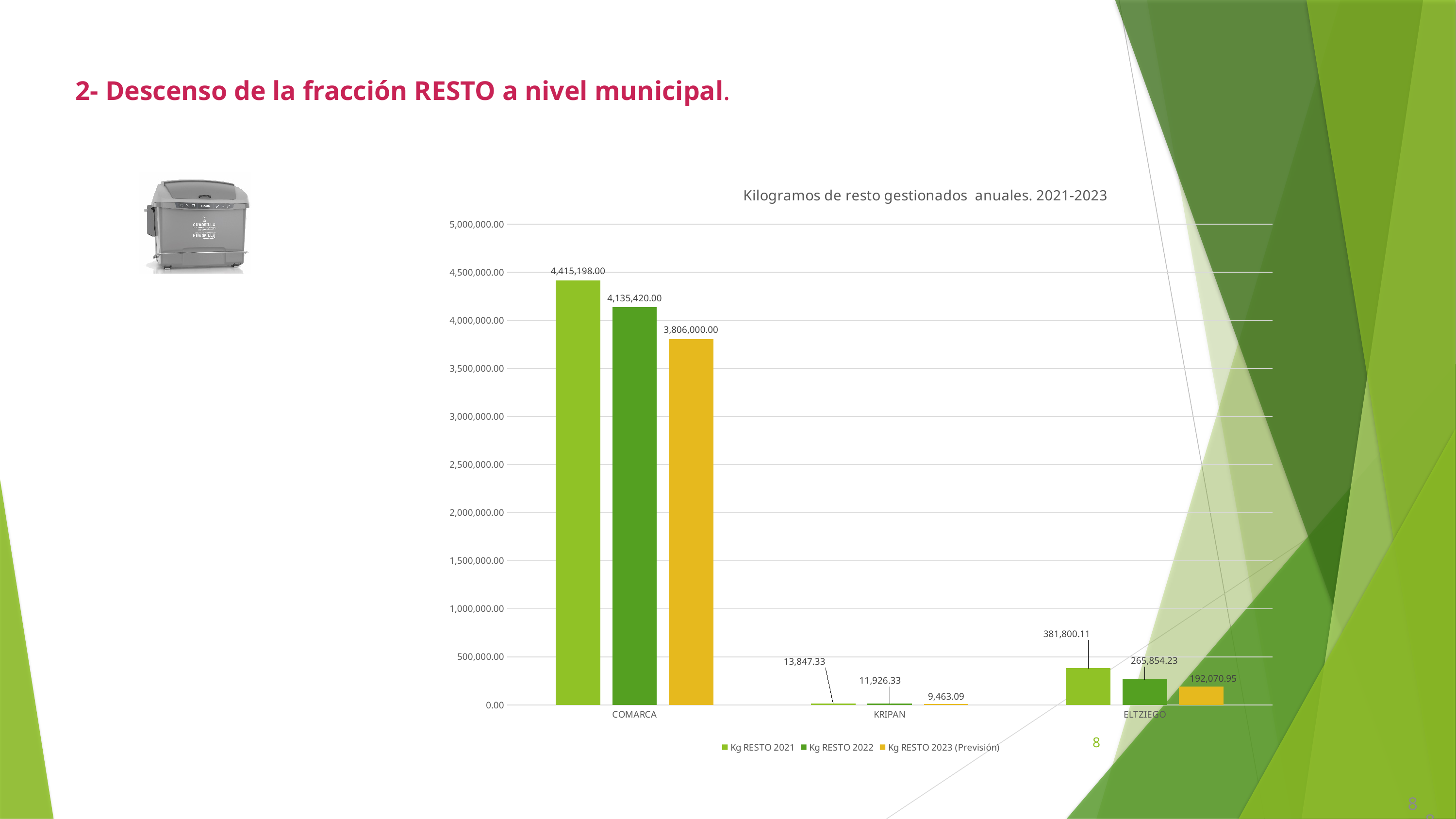
How many series does the legend list? 3 How many categories are shown on the x axis? 3 Is the Kg RESTO 2023 (Previsión) value for COMARCA greater or less than 4,000,000.00? less What type of chart is shown on the slide? bar chart What is the value of Kg RESTO 2022 for KRIPAN? 11,926.33 What is the value of Kg RESTO 2021 for COMARCA? 4,415,198.00 Which is larger for ELTZIEGO: Kg RESTO 2021 or Kg RESTO 2022? Kg RESTO 2021 What is the difference between Kg RESTO 2021 and Kg RESTO 2023 (Previsión) for ELTZIEGO? 189,729.16 Which category has the lowest Kg RESTO 2023 (Previsión) value? KRIPAN What is the difference between Kg RESTO 2021 and Kg RESTO 2022 for COMARCA? 279,778.00 Which category has the highest Kg RESTO 2021 value? COMARCA What is the value of Kg RESTO 2023 (Previsión) for ELTZIEGO? 192,070.95